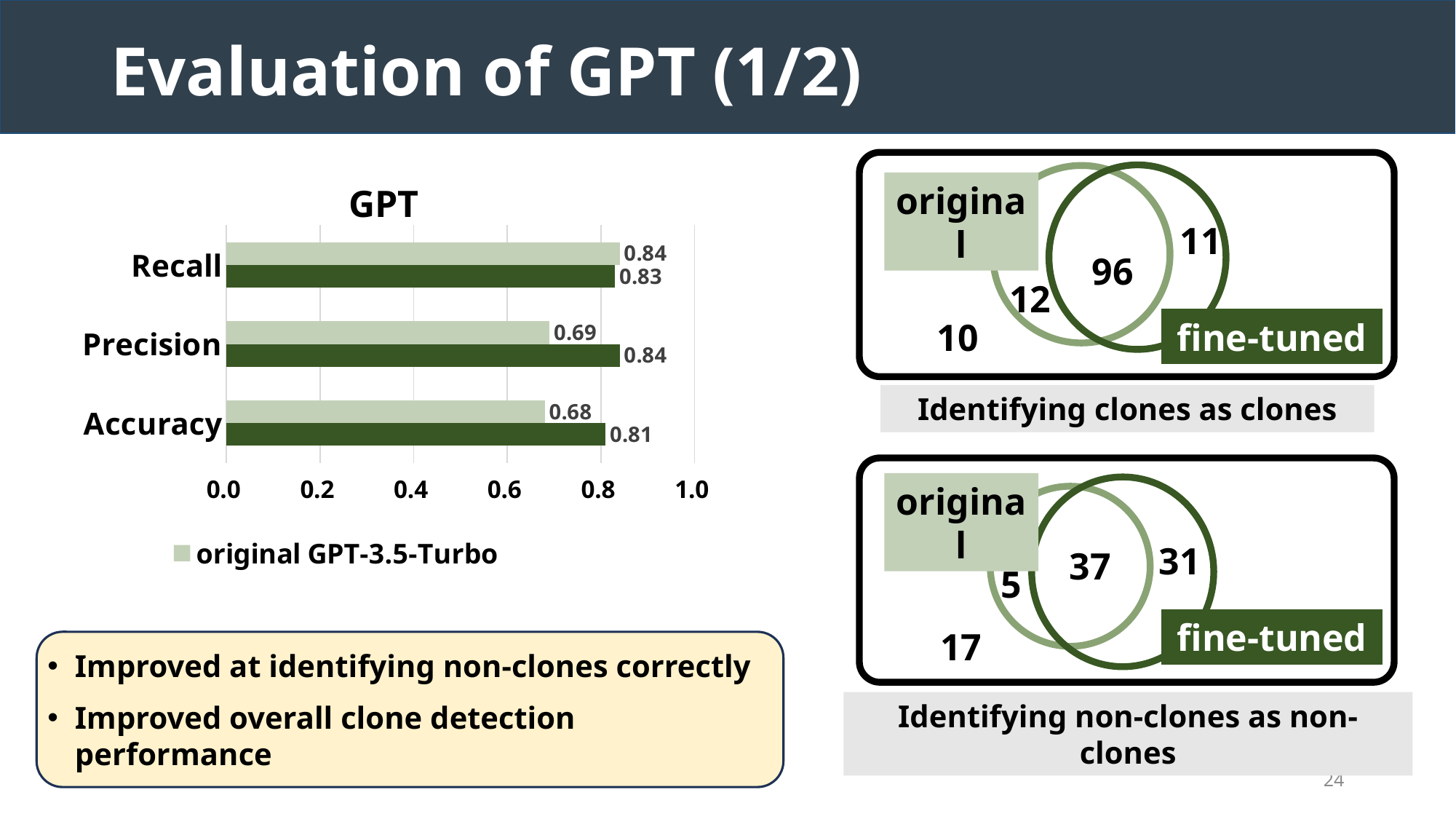
In the GPT bar chart, which metric has the lowest value for original GPT-3.5-Turbo? Accuracy In the GPT bar chart, what is the difference between the dark green Precision bar (0.84) and the original GPT-3.5-Turbo Precision bar (0.69)? 0.15 In the GPT bar chart, which Recall bar is larger: the original GPT-3.5-Turbo bar or the dark green bar? original GPT-3.5-Turbo In the GPT bar chart, what is the Recall value for original GPT-3.5-Turbo? 0.84 How many metric categories are shown on the y axis of the GPT bar chart? 3 In the GPT bar chart, what is the Precision value shown on the dark green bar? 0.84 In the GPT bar chart, which metric has the highest value for original GPT-3.5-Turbo? Recall In the GPT bar chart, what is the Accuracy value shown on the dark green bar? 0.81 In the GPT bar chart, what is the Accuracy value for original GPT-3.5-Turbo? 0.68 In the GPT bar chart, what is the Precision value for original GPT-3.5-Turbo? 0.69 In the GPT bar chart, what is the difference between the dark green Accuracy bar (0.81) and the original GPT-3.5-Turbo Accuracy bar (0.68)? 0.13 What kind of chart is the GPT chart on the left of the slide? bar chart